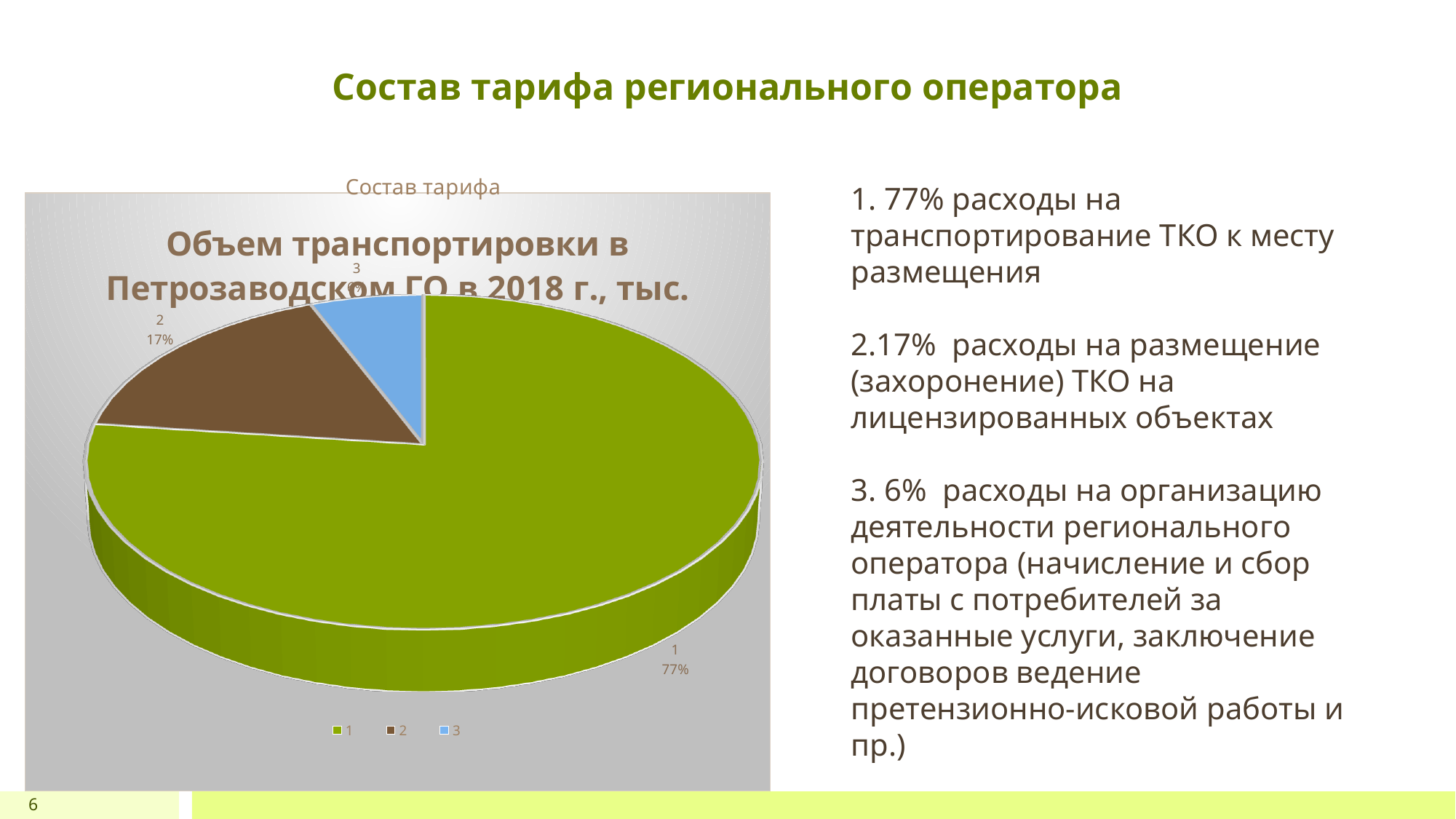
How many slices does the pie chart have? 3 Is the share of slice 1 greater or less than 50%? greater What is the difference in percentage points between slice 1 and slice 2? 60 What colour is slice 1 in the pie chart? green What share of the pie does slice 1 represent? 77% How many entries does the legend of the pie chart list? 3 Which slice of the pie chart is the smallest? 3 Which slice of the pie chart is the largest? 1 What kind of chart is shown on the slide? pie chart Which is larger in the pie chart, slice 2 or slice 3? 2 What is the title of the pie chart? Состав тарифа What share of the pie does slice 2 represent? 17%